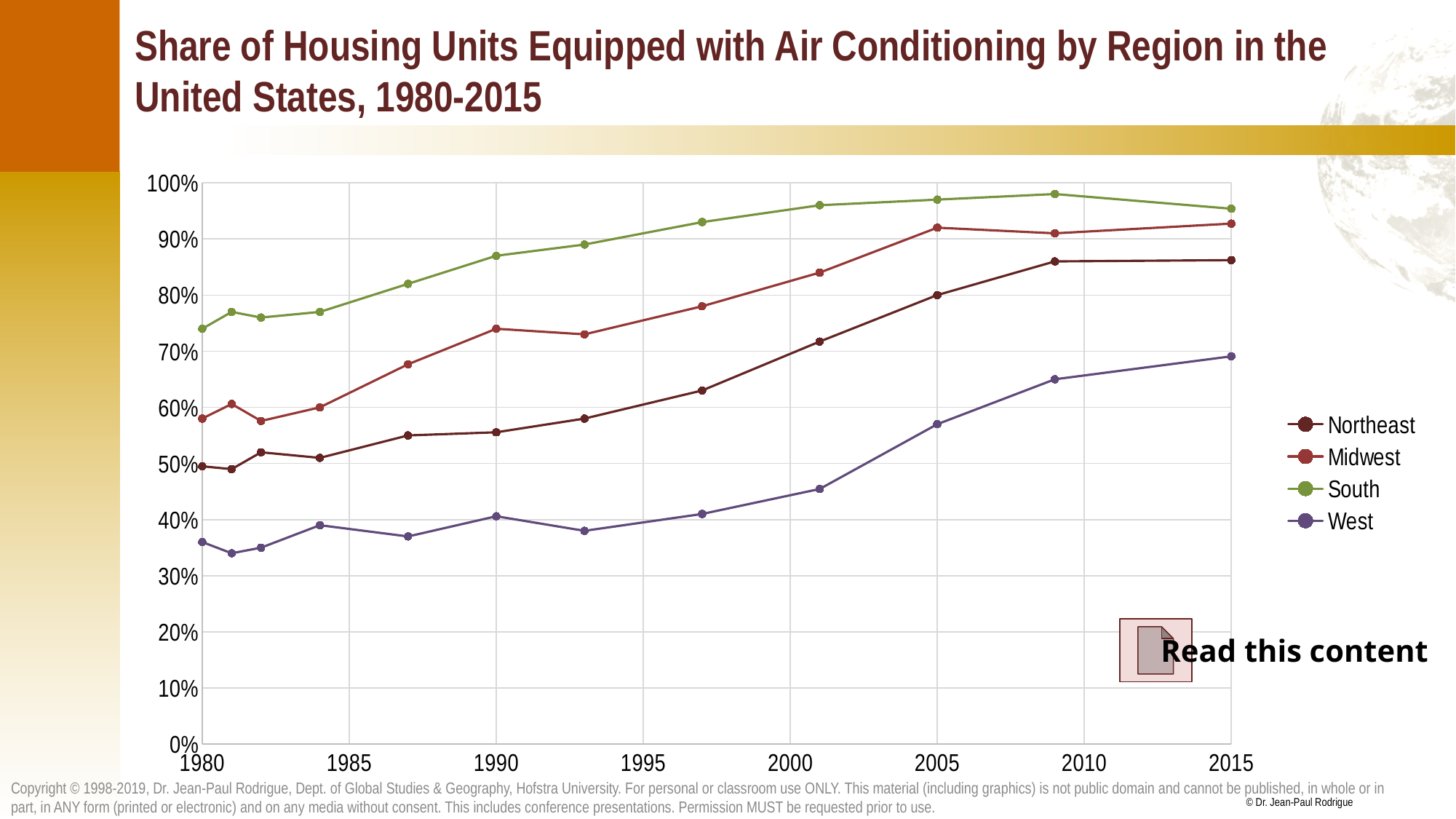
Does the share for the West generally rise or fall from 1980 to 2015? rise Which region has the lowest share of housing units with air conditioning in 2015? West Which region has the highest share of housing units with air conditioning in 2015? South What is the title of the chart? Share of Housing Units Equipped with Air Conditioning by Region in the United States, 1980-2015 How many series does the legend list? 4 Which region has the lowest share in 1980? West In 2005, which is larger: the value for Midwest or the value for Northeast? Midwest Is the value for West in 2015 greater or less than 60%? greater Is the value for Midwest in 1980 greater or less than 50%? greater Is the value for South in 2015 greater or less than 90%? greater What kind of chart is shown on the slide? line chart